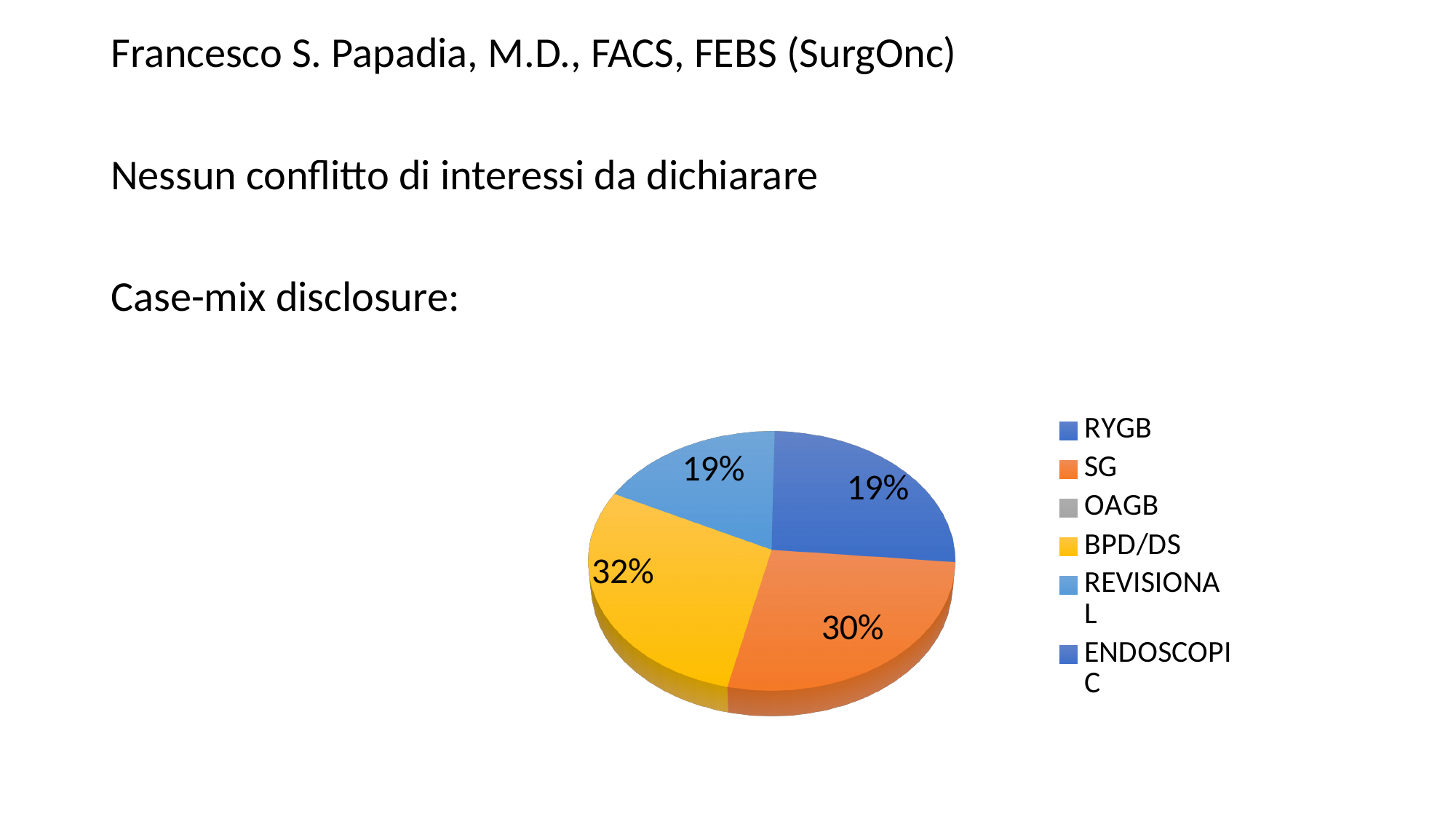
What percentage of the pie chart does RYGB represent? 19% What is the difference in percentage points between the BPD/DS slice and the RYGB slice? 13 Which category has the largest slice of the pie chart? BPD/DS What percentage of the pie chart does SG represent? 30% How many entries does the legend of the pie chart list? 6 Which is larger in the pie chart, SG or BPD/DS? BPD/DS How many slices with visible data labels are shown in the pie chart? 4 What type of chart is shown on the slide? pie chart What is the combined share of the SG and BPD/DS slices? 62% What percentage of the pie chart does REVISIONAL represent? 19% What percentage of the pie chart does BPD/DS represent? 32% What colour is the BPD/DS slice in the pie chart? yellow